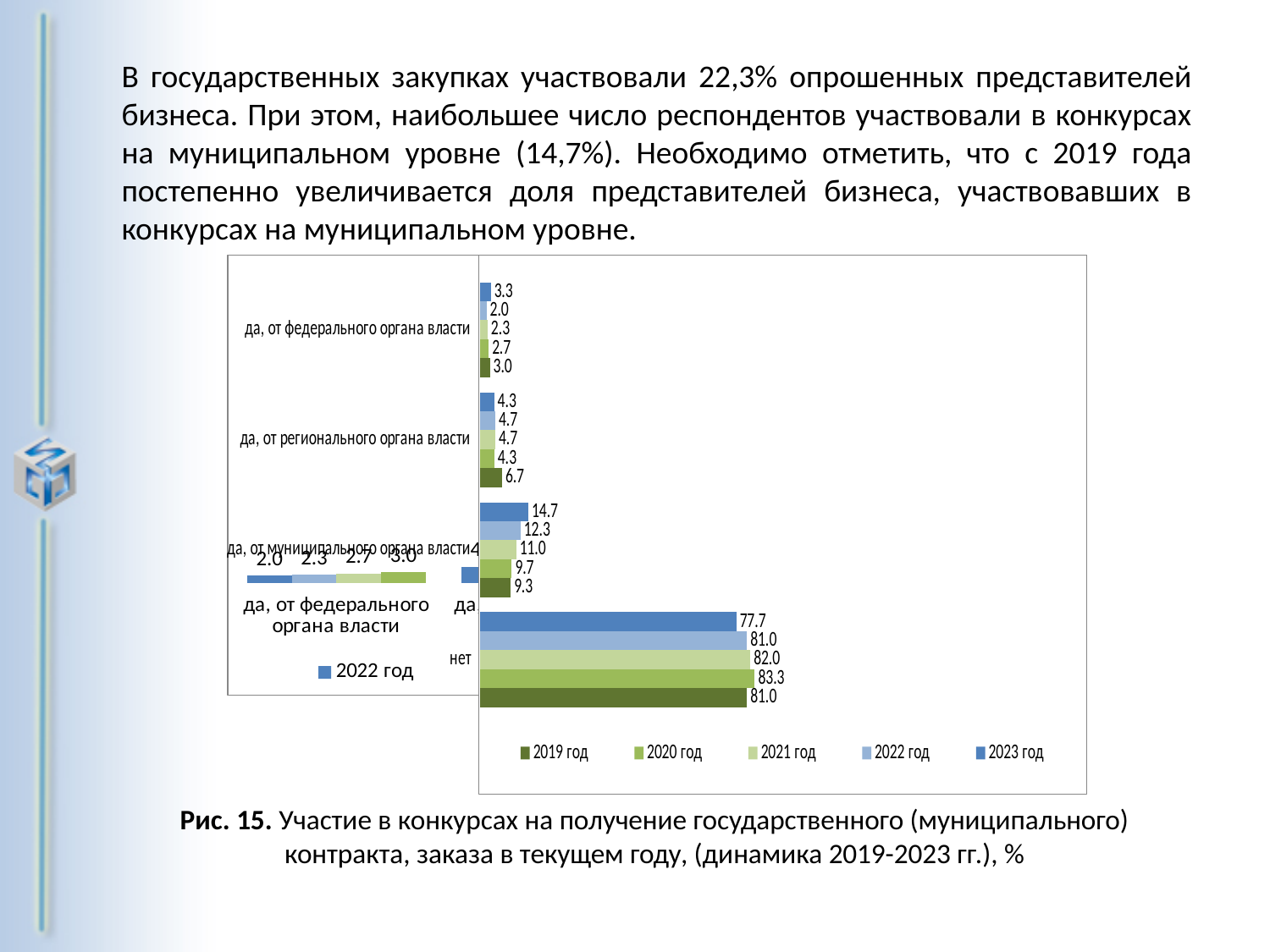
How many series does the legend of the main chart (Рис. 15) list? 5 In the main chart (Рис. 15), what is the value for 'да, от регионального органа власти' in 2019 год? 6.7 In the main chart (Рис. 15), which year has the lowest value for 'нет'? 2023 год What kind of chart is the main chart (Рис. 15)? bar chart In the main chart (Рис. 15), what is the value for 'нет' in 2020 год? 83.3 In the main chart (Рис. 15), which is larger for 'да, от федерального органа власти': the 2023 год value or the 2019 год value? 2023 год In the main chart (Рис. 15), what is the value for 'да, от муниципального органа власти' in 2023 год? 14.7 In the main chart (Рис. 15), do the values for 'да, от муниципального органа власти' rise or fall from 2019 год to 2023 год? rise In the main chart (Рис. 15), what is the difference between the 2023 год and 2019 год values for 'да, от муниципального органа власти'? 5.4 In the main chart (Рис. 15), which year has the highest value for 'да, от муниципального органа власти'? 2023 год How many categories are shown on the main chart (Рис. 15)? 4 In the main chart (Рис. 15), what is the difference between the 2020 год and 2023 год values for 'нет'? 5.6